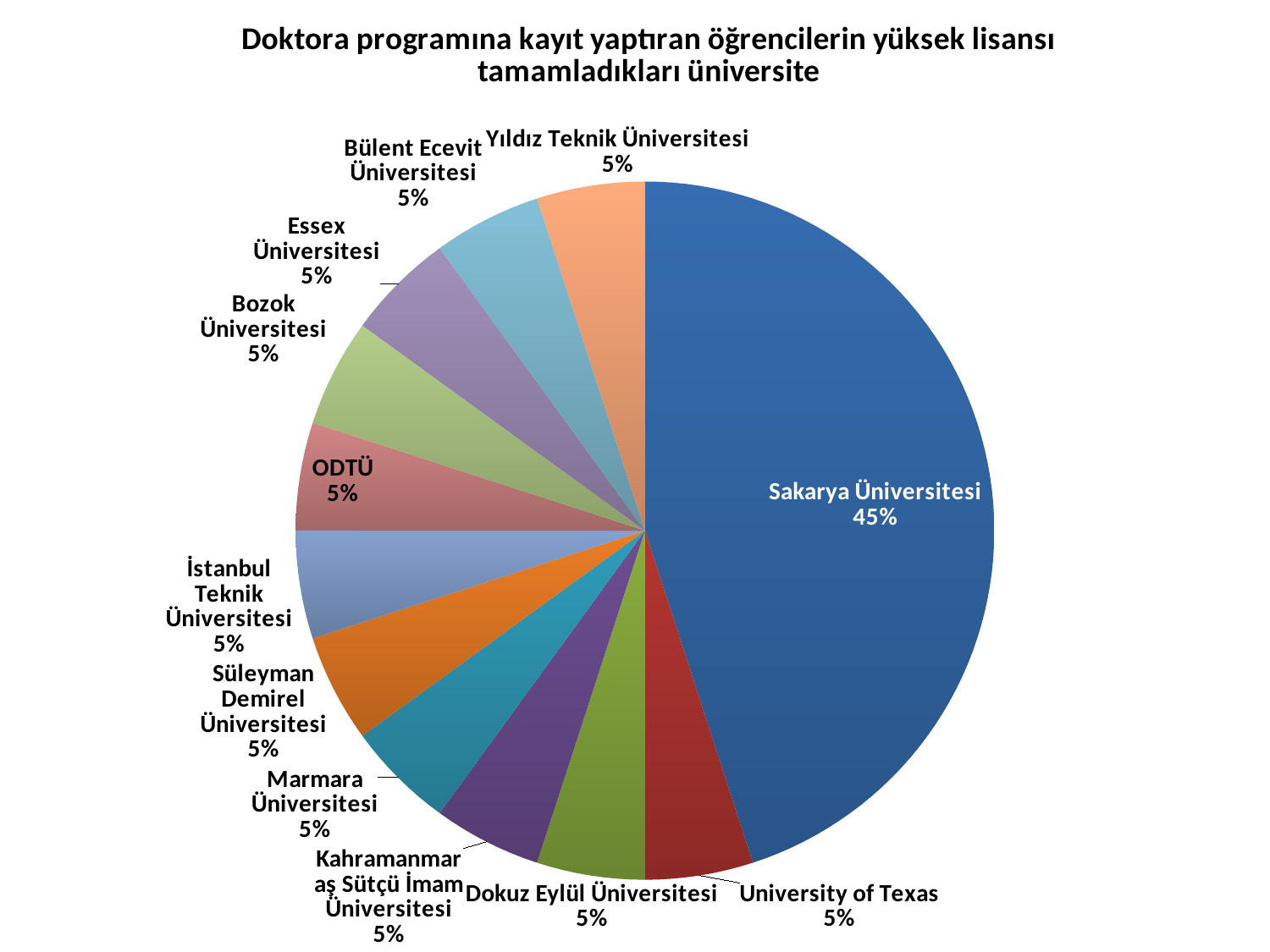
Which is larger, the slice for Sakarya Üniversitesi or the slice for Dokuz Eylül Üniversitesi? Sakarya Üniversitesi How many slices does the pie chart have? 12 What is the value shown for Yıldız Teknik Üniversitesi? 5% What is the combined share of Bozok Üniversitesi and Bülent Ecevit Üniversitesi? 10% What is the difference between the share for Sakarya Üniversitesi and the share for Marmara Üniversitesi? 40% What is the title of the chart? Doktora programına kayıt yaptıran öğrencilerin yüksek lisansı tamamladıkları üniversite What is the value shown for ODTÜ? 5% What is the value shown for Essex Üniversitesi? 5% Which university has the largest slice of the pie? Sakarya Üniversitesi What is the value shown for University of Texas? 5% What share of the pie does Sakarya Üniversitesi have? 45% What kind of chart is shown on the slide? pie chart